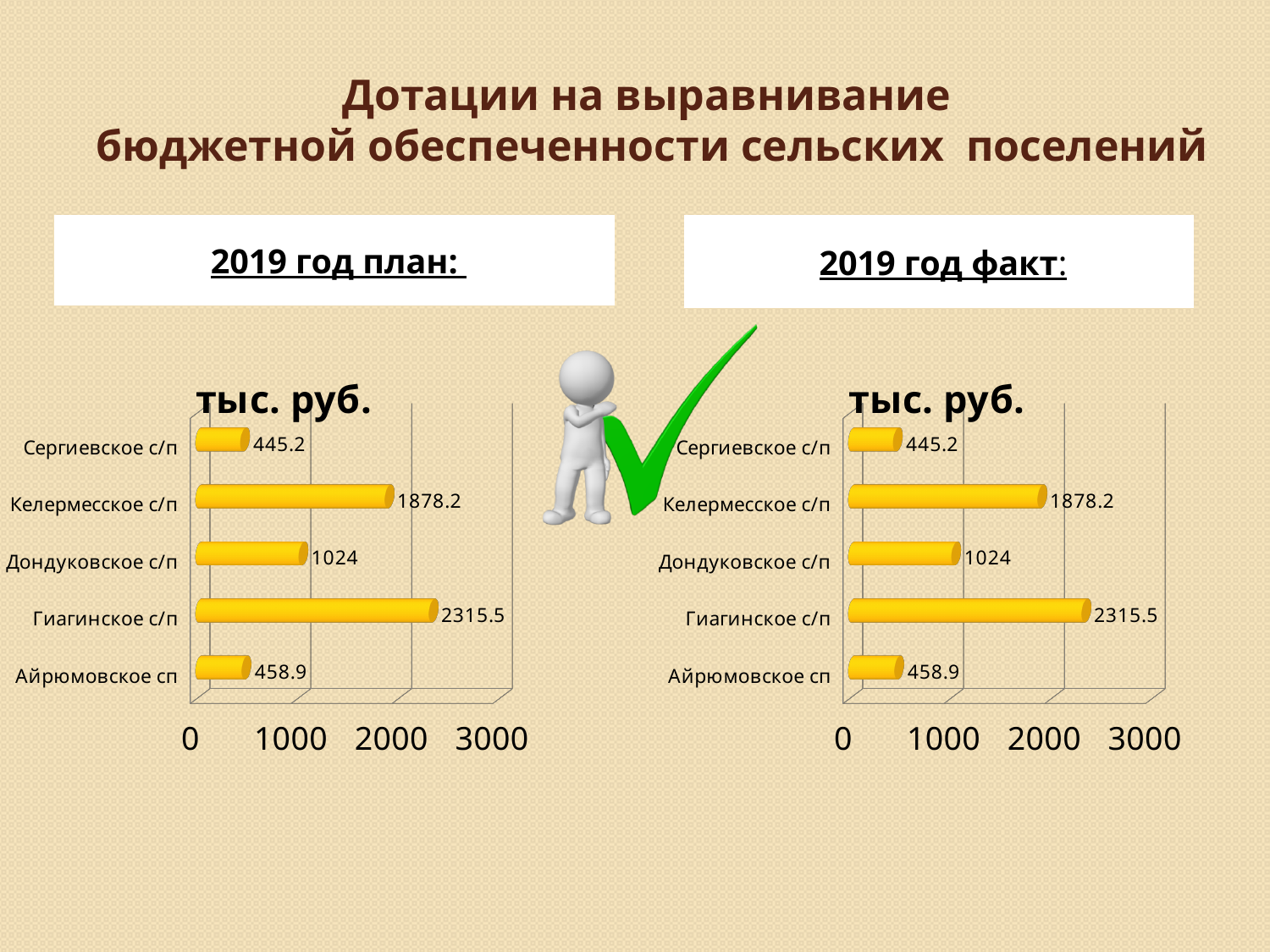
What is the title of the left chart (2019 год план)? тыс. руб. In the left chart (2019 год план), what is the value for Гиагинское с/п? 2315.5 In the right chart (2019 год факт), is the value for Сергиевское с/п greater or less than 1000? less In the left chart (2019 год план), what is the value for Айрюмовское сп? 458.9 How many categories are shown in the left chart (2019 год план)? 5 In the left chart (2019 год план), what is the difference between Айрюмовское сп and Сергиевское с/п? 13.7 In the right chart (2019 год факт), which category has the highest value? Гиагинское с/п In the right chart (2019 год факт), what is the difference between Гиагинское с/п and Дондуковское с/п? 1291.5 In the left chart (2019 год план), which is larger: Келермесское с/п or Дондуковское с/п? Келермесское с/п In the left chart (2019 год план), which category has the lowest value? Сергиевское с/п In the right chart (2019 год факт), what is the value for Келермесское с/п? 1878.2 What type of chart is the right chart (2019 год факт)? bar chart